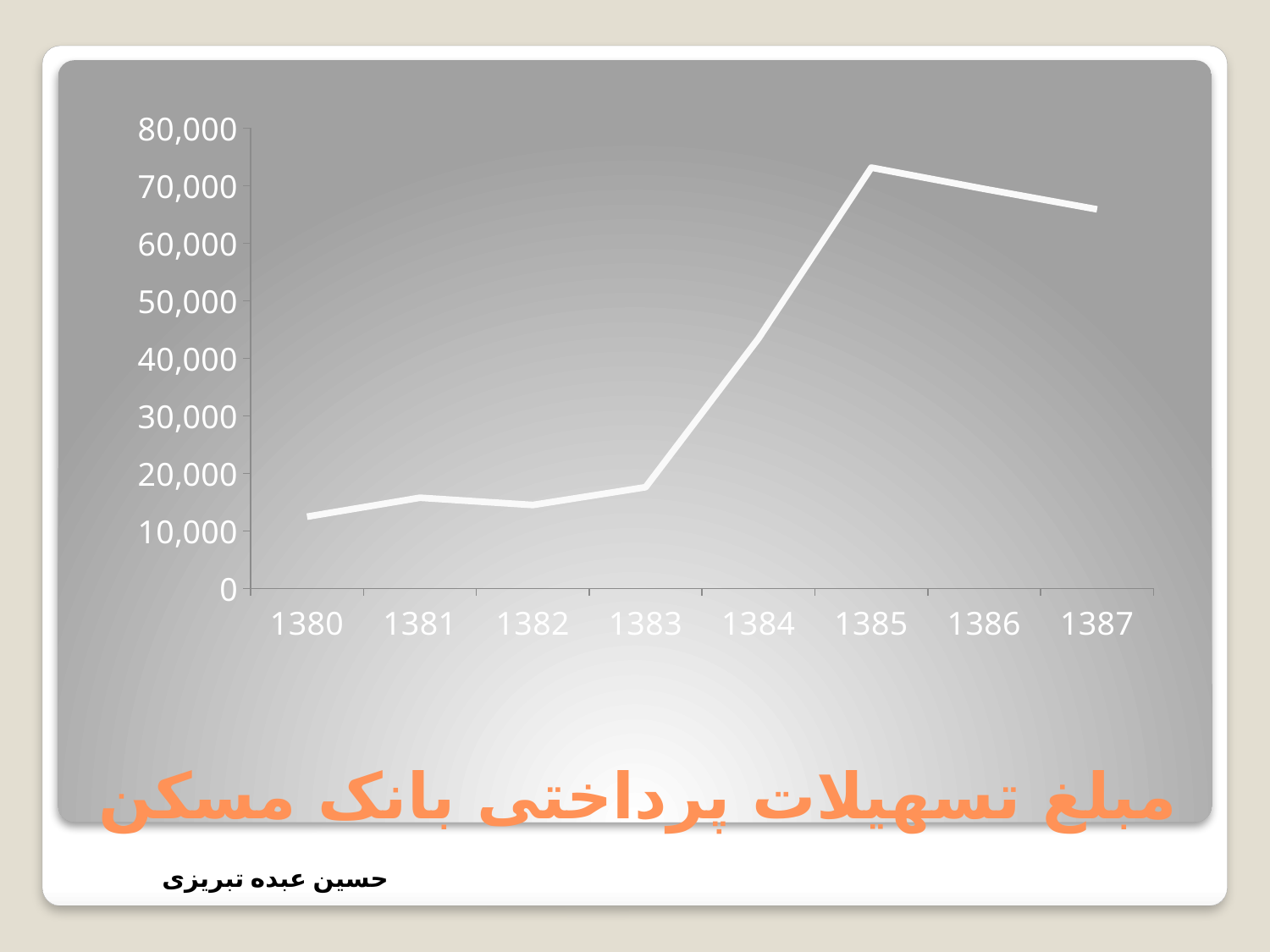
Is the value for 1385 greater or less than 70,000? greater Which is larger, the value for 1385 or the value for 1387? 1385 What is the title shown on the slide for this chart? مبلغ تسهیلات پرداختی بانک مسکن Is the value for 1387 greater or less than 60,000? greater How many years are plotted along the x axis? 8 Is the value for 1380 greater or less than 20,000? less Which year has the lowest value? 1380 Which year has the highest value? 1385 What kind of chart is shown on the slide? line chart Does the line rise or fall between 1385 and 1387? fall Which is larger, the value for 1383 or the value for 1384? 1384